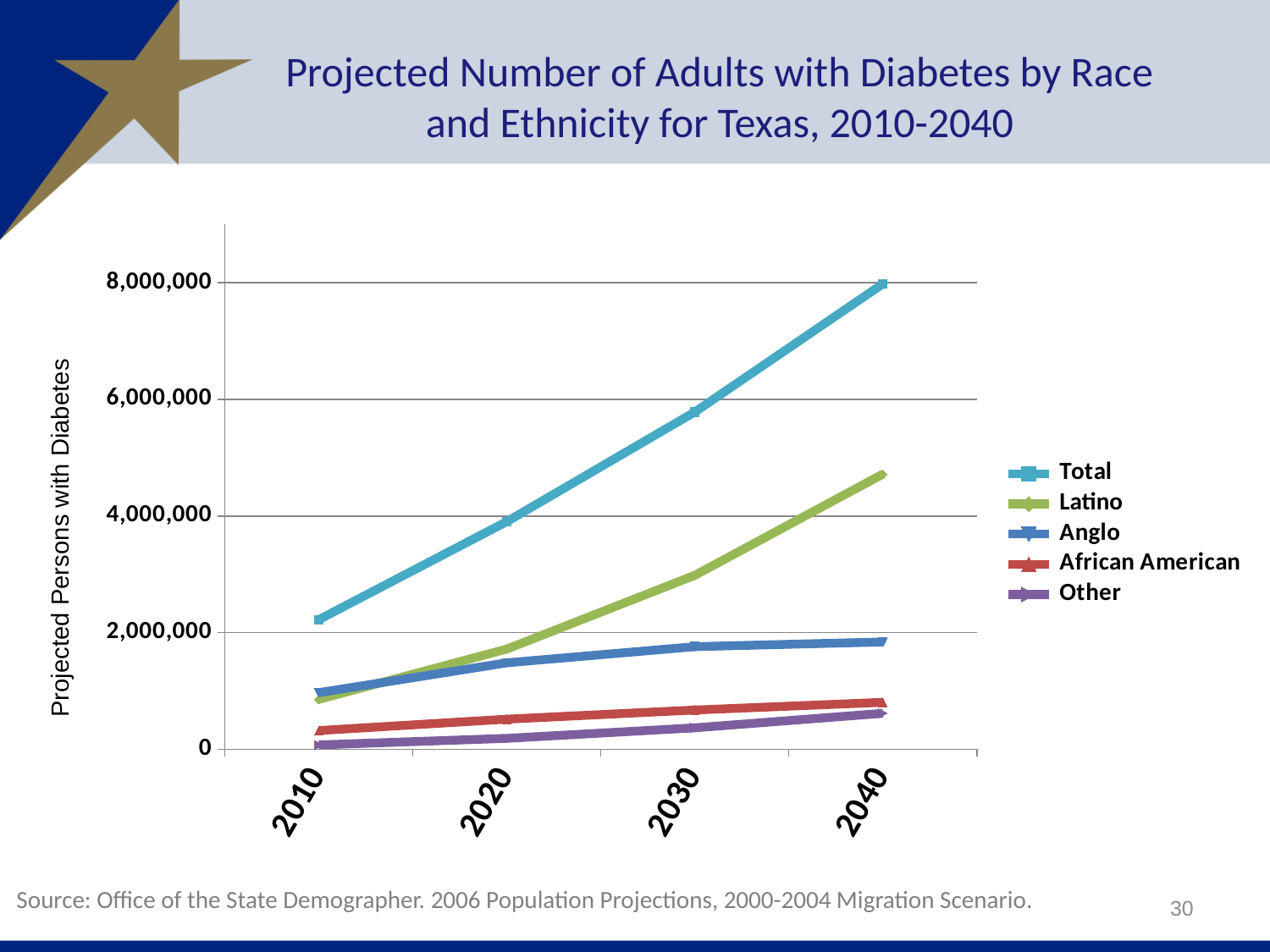
How many years are plotted along the x axis? 4 Is the value for Latino in 2040 greater or less than 4,000,000? greater Is the value for Anglo in 2040 greater or less than 2,000,000? less Is the value for Total in 2010 greater or less than 2,000,000? greater Which series has the lowest value in 2040? Other In 2040, which is larger, the value for Latino or the value for Anglo? Latino How many series does the legend list? 5 What kind of chart is shown on the slide? line chart Which series has the highest value in 2040? Total What is the label on the y axis? Projected Persons with Diabetes Does the Total series rise or fall from 2010 to 2040? rise